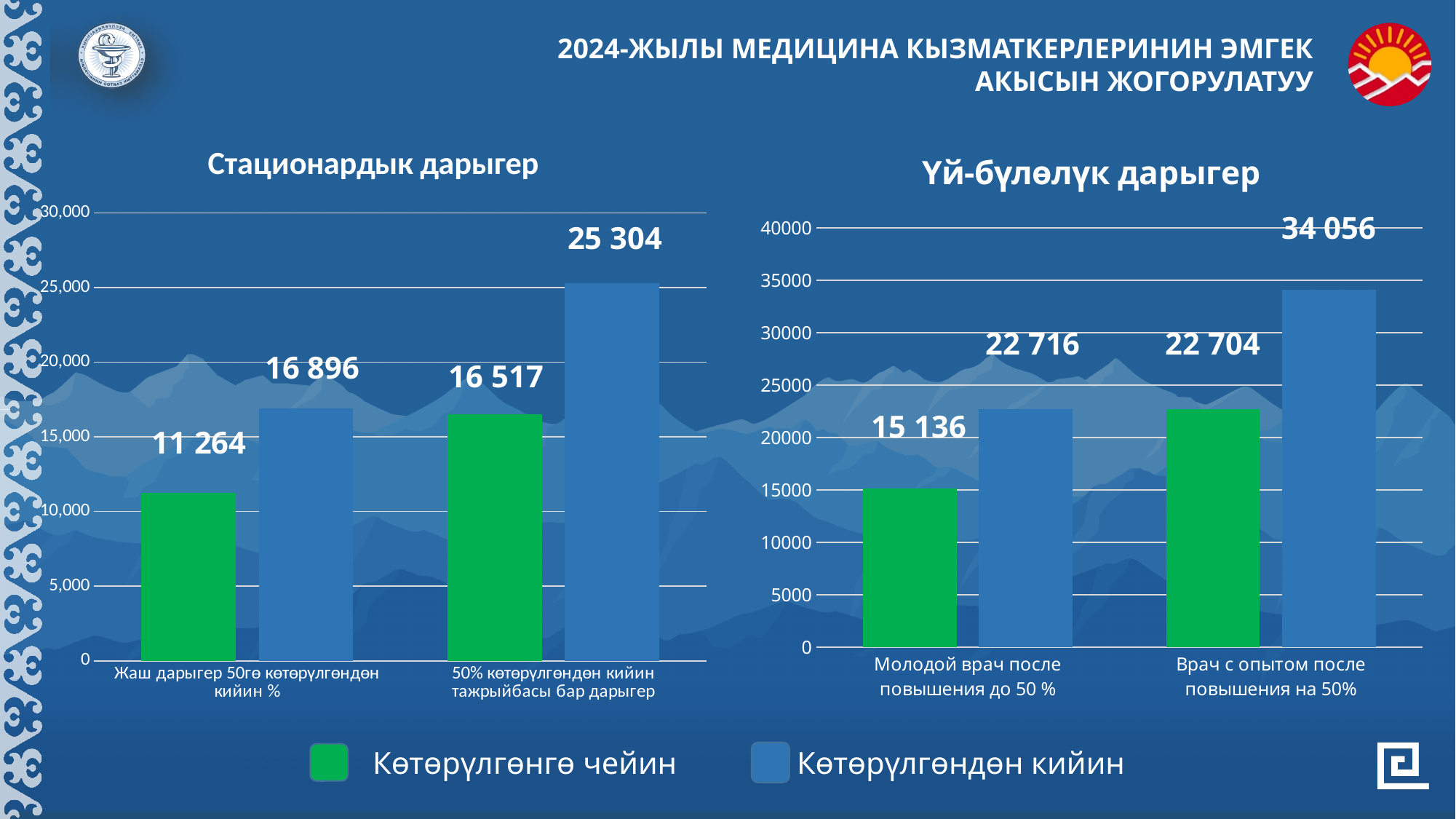
What type of chart is the chart titled "Стационардык дарыгер"? Bar chart In the chart titled "Стационардык дарыгер", which bar has the lowest value? Көтөрүлгөнгө чейин for Жаш дарыгер 50гө көтөрүлгөндөн кийин % (11 264) In the chart titled "Стационардык дарыгер", what is the value of the green bar (Көтөрүлгөнгө чейин) for "Жаш дарыгер 50гө көтөрүлгөндөн кийин %"? 11 264 How many categories are shown on the x axis of the chart titled "Үй-бүлөлүк дарыгер"? 2 In the chart titled "Стационардык дарыгер", which is larger: the blue bar for "Жаш дарыгер 50гө көтөрүлгөндөн кийин %" or the green bar for "50% көтөрүлгөндөн кийин тажрыйбасы бар дарыгер"? The blue bar for Жаш дарыгер (16 896) In the chart titled "Үй-бүлөлүк дарыгер", what is the value of the green bar (Көтөрүлгөнгө чейин) for "Врач с опытом после повышения на 50%"? 22 704 How many series does the legend at the bottom of the slide list? 2 In the chart titled "Үй-бүлөлүк дарыгер", what is the difference between the blue and green bars for "Врач с опытом после повышения на 50%"? 11 352 In the chart titled "Үй-бүлөлүк дарыгер", which bar has the highest value? Көтөрүлгөндөн кийин for Врач с опытом после повышения на 50% (34 056) In the chart titled "Стационардык дарыгер", what is the difference between the blue and green bars for "Жаш дарыгер 50гө көтөрүлгөндөн кийин %"? 5 632 In the chart titled "Үй-бүлөлүк дарыгер", what is the value of the blue bar (Көтөрүлгөндөн кийин) for "Молодой врач после повышения до 50 %"? 22 716 In the chart titled "Стационардык дарыгер", what is the value of the blue bar (Көтөрүлгөндөн кийин) for "50% көтөрүлгөндөн кийин тажрыйбасы бар дарыгер"? 25 304